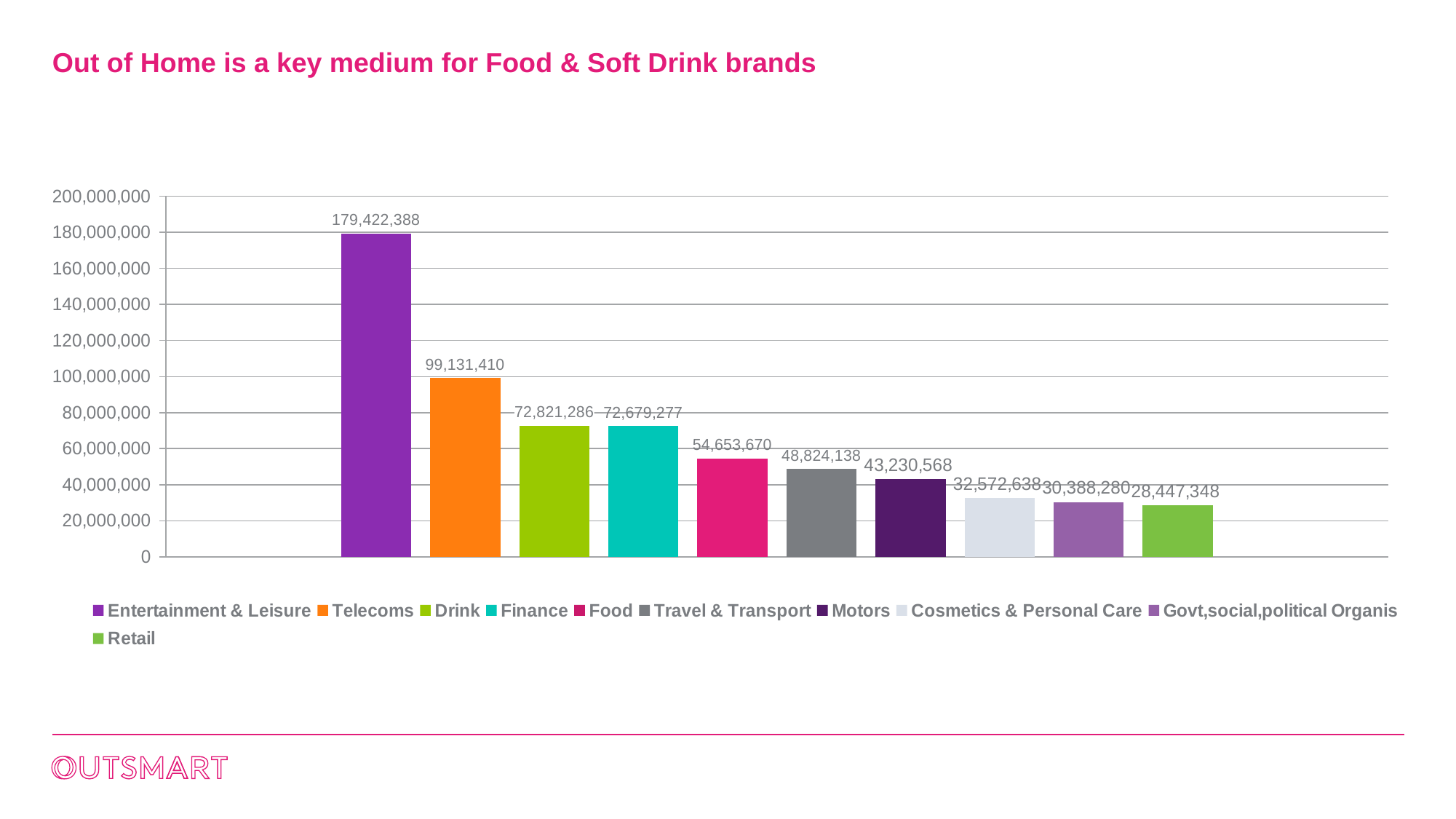
What kind of chart is shown on the slide? Bar chart What is the value for Food? 54,653,670 What is the value for Cosmetics & Personal Care? 32,572,638 Which category has the highest value? Entertainment & Leisure What is the value for Retail? 28,447,348 Which category has the lowest value? Retail Which is larger, the value for Drink or the value for Finance? Drink What is the difference between the values for Entertainment & Leisure and Telecoms? 80,290,978 Is the value for Motors greater or less than 40,000,000? greater What is the value for Entertainment & Leisure? 179,422,388 How many categories are plotted in the chart? 10 What is the difference between the values for Food and Travel & Transport? 5,829,532